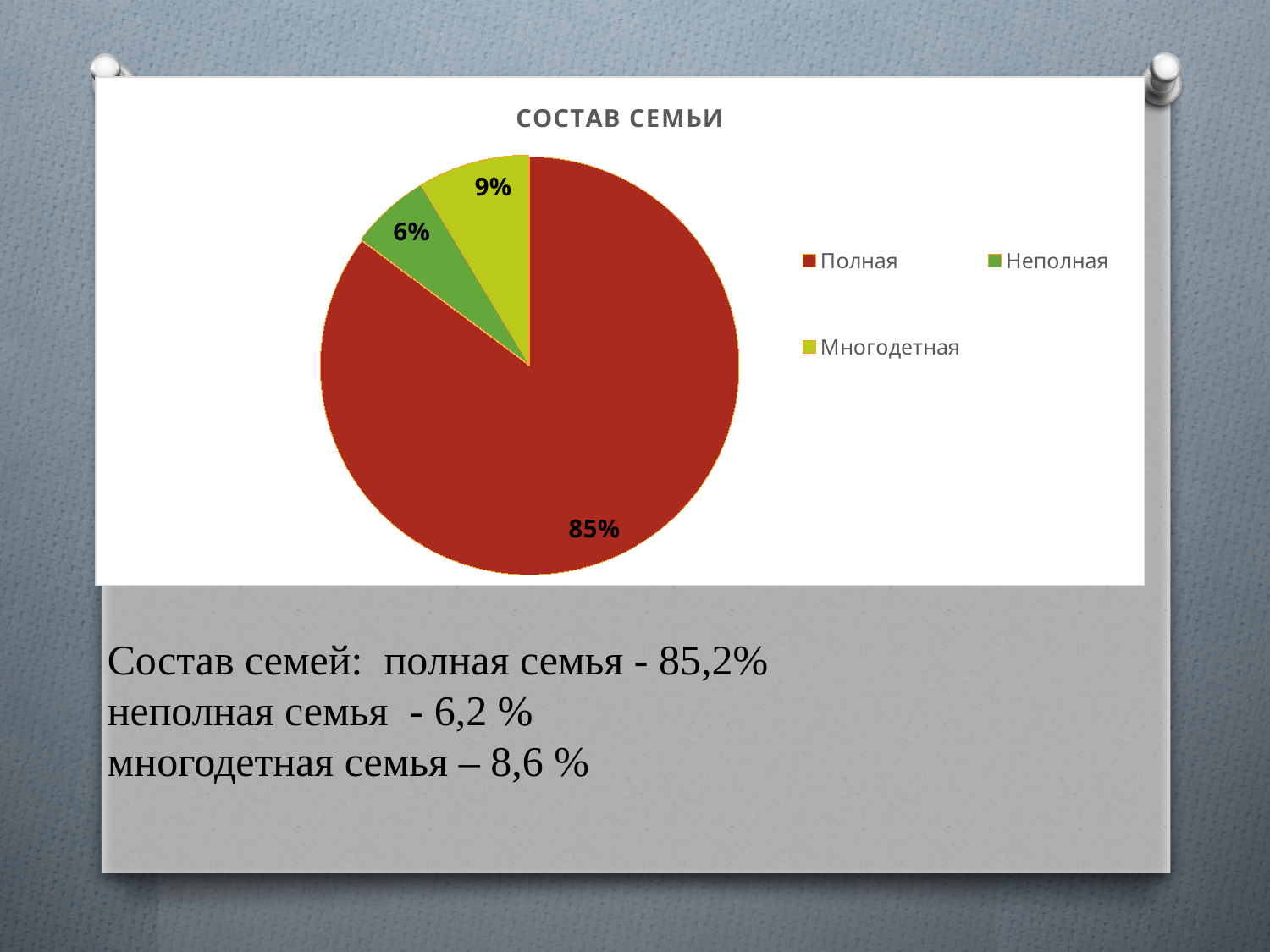
What is the title of the chart? СОСТАВ СЕМЬИ How many slices does the pie chart have? 3 What percentage does the Полная slice show? 85% What kind of chart is shown on the slide? pie chart What colour is the Полная slice? red Which category has the largest slice of the pie? Полная Which slice is larger, Многодетная or Неполная? Многодетная How many entries does the legend list? 3 What percentage does the Неполная slice show? 6% What percentage does the Многодетная slice show? 9% What is the difference in percentage points between the Полная and Многодетная slices? 76 Which category has the smallest slice of the pie? Неполная